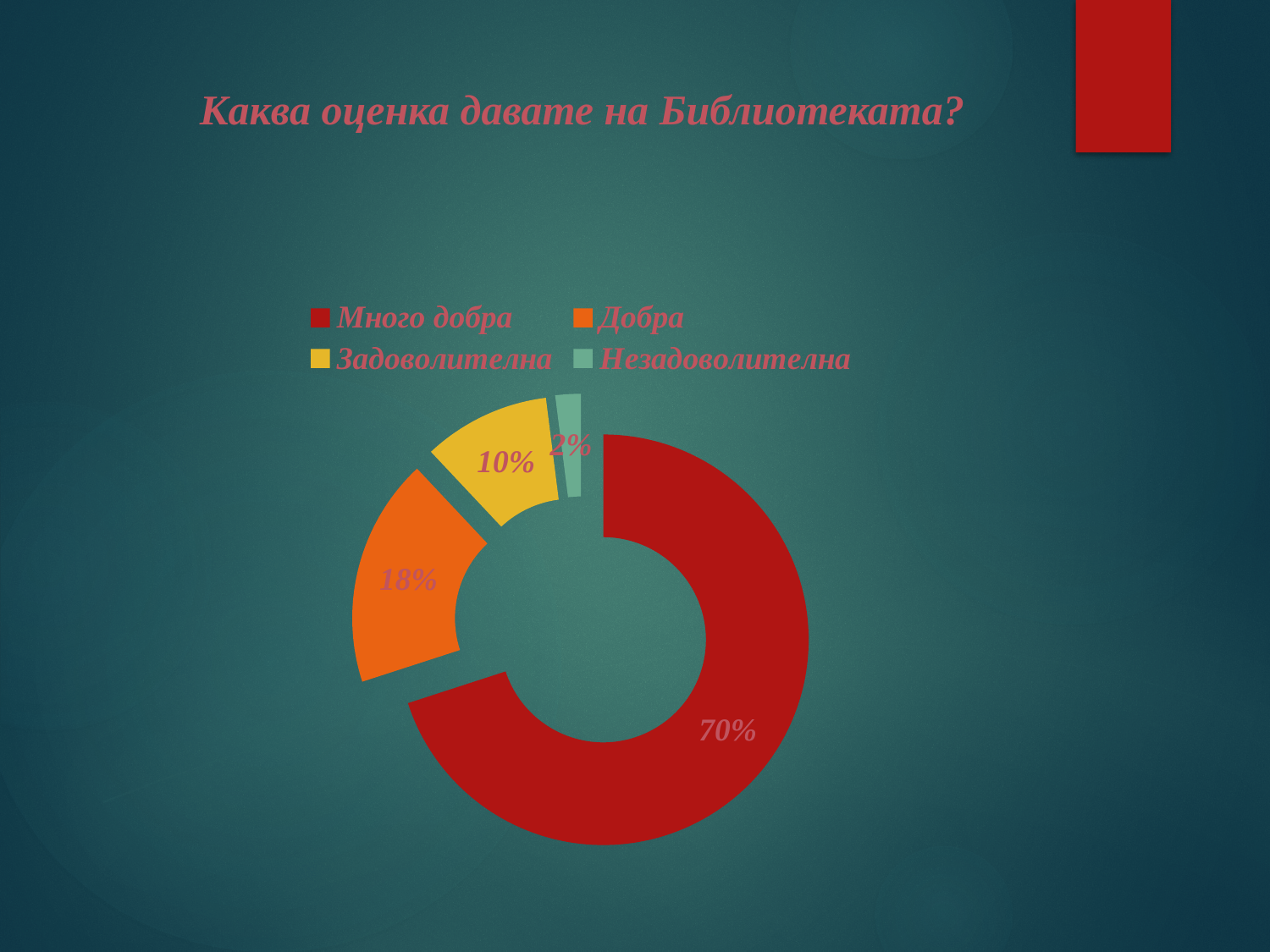
What percentage is shown for "Незадоволителна"? 2% Which rating category has the smallest share? Незадоволителна What is the difference in percentage points between "Задоволителна" and "Незадоволителна"? 8 What share does the "Задоволителна" slice have? 10% What is the difference in percentage points between "Много добра" and "Добра"? 52 Which rating category has the largest share? Много добра How many categories does the chart show? 4 What kind of chart is shown on the slide? Doughnut (pie) chart What percentage of respondents rated the library as "Много добра"? 70% What percentage of respondents gave the rating "Добра"? 18% What is the title of the chart on the slide? Каква оценка давате на Библиотеката? Which is larger, the share for "Добра" or the share for "Задоволителна"? Добра